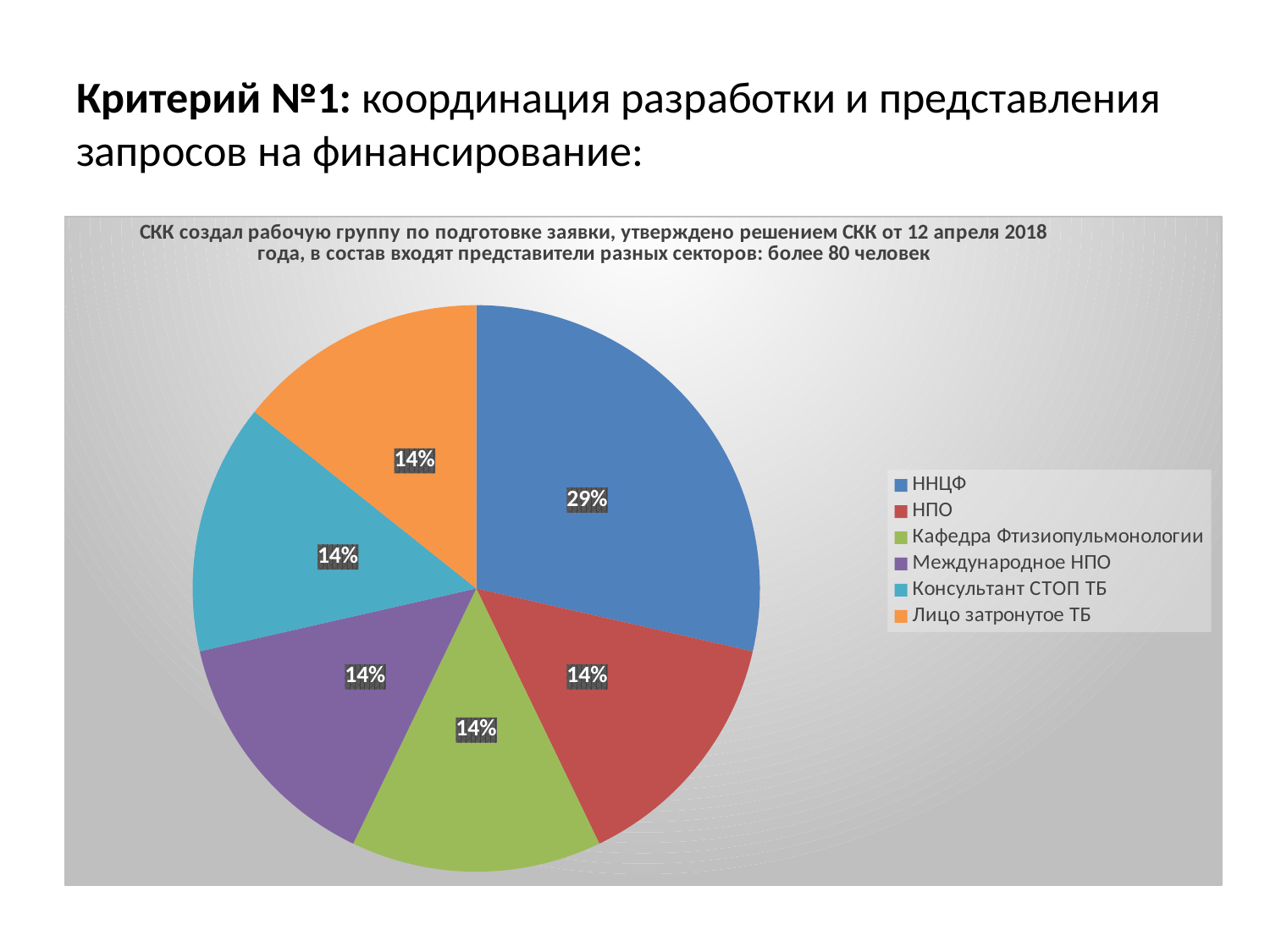
How many categories are listed in the legend? 6 What share of the pie does НПО have? 14% Which colour represents Консультант СТОП ТБ in the pie chart? light blue Which category has the largest share of the pie? ННЦФ What is the difference in percentage points between the share of ННЦФ and the share of Международное НПО? 15 What share of the pie does Лицо затронутое ТБ have? 14% How many slices does the pie chart have? 6 What share of the pie does ННЦФ have? 29% Which has a larger share, ННЦФ or Консультант СТОП ТБ? ННЦФ What share of the pie does Кафедра Фтизиопульмонологии have? 14% What kind of chart is shown on the slide? pie chart According to the chart title, how many people are in the working group? более 80 человек